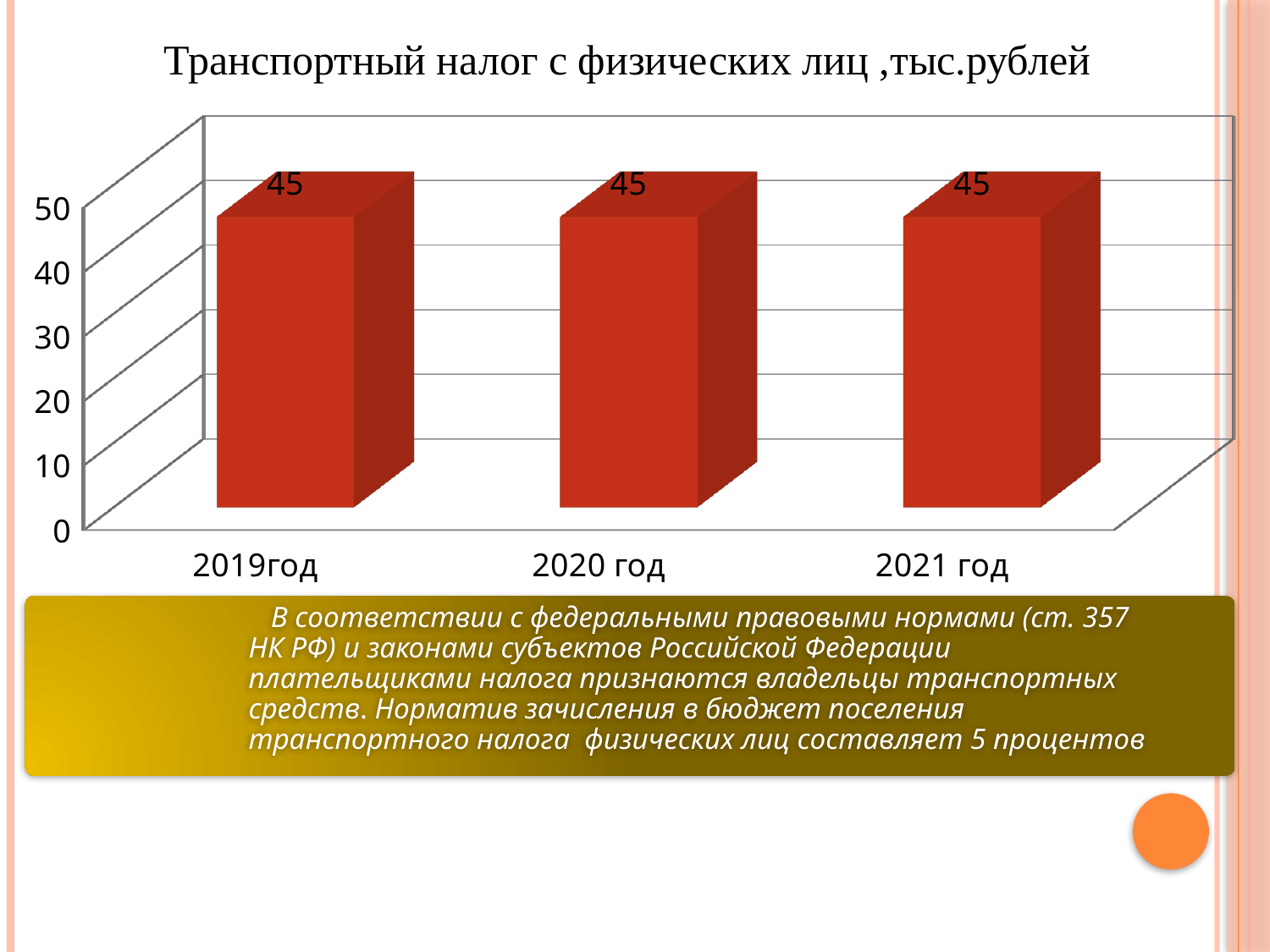
What is the title of the chart? Транспортный налог с физических лиц ,тыс.рублей Do the values rise, fall or stay the same from 2019год to 2021 год? stay the same How many categories are shown on the x axis? 3 What is the difference between the values for 2019год and 2021 год? 0 Is the value for 2020 год greater or less than 40? greater What is the value for 2019год? 45 What is the value for 2020 год? 45 What colour are the bars in the chart? red What is the value for 2021 год? 45 What is the highest tick value shown on the vertical axis? 50 What kind of chart is shown on the slide? bar chart Is the value for 2021 год greater or less than 50? less